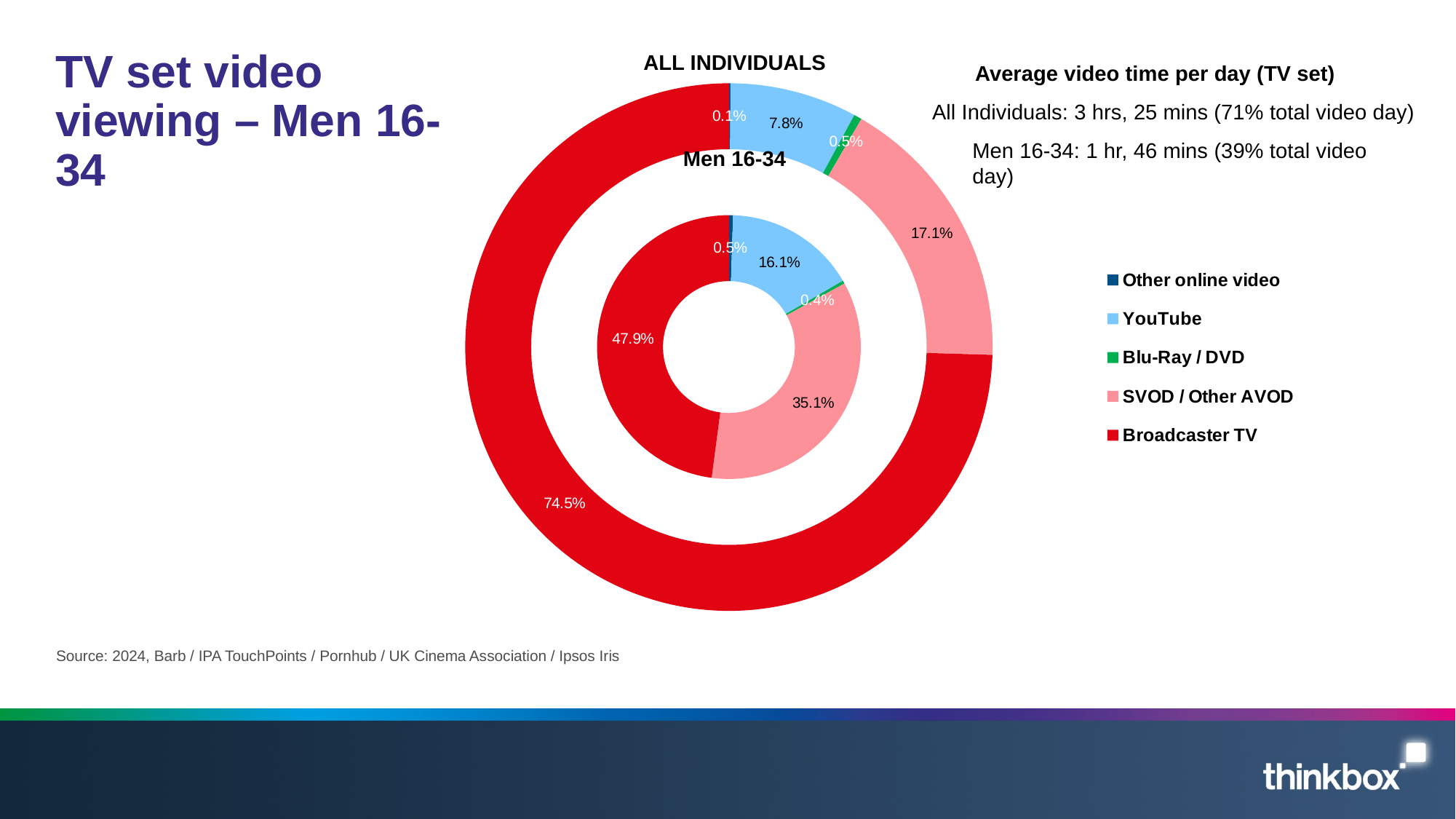
Which is larger: the SVOD / Other AVOD share for Men 16-34 or for All Individuals? Men 16-34 What is the difference between the Broadcaster TV share for All Individuals and for Men 16-34? 26.6 percentage points What is the SVOD / Other AVOD share for All Individuals (outer ring)? 17.1% What type of chart is shown on the slide? Doughnut chart How many categories does the legend list? 5 Which category has the smallest share in the All Individuals ring? Other online video Which category has the largest share in the Men 16-34 ring? Broadcaster TV Which colour represents YouTube in the chart? Light blue What is the Blu-Ray / DVD share for Men 16-34 (inner ring)? 0.4% What share of TV set video viewing for All Individuals (outer ring) is Broadcaster TV? 74.5% What is the YouTube share for Men 16-34 (inner ring)? 16.1% What share of TV set video viewing for Men 16-34 (inner ring) is Broadcaster TV? 47.9%